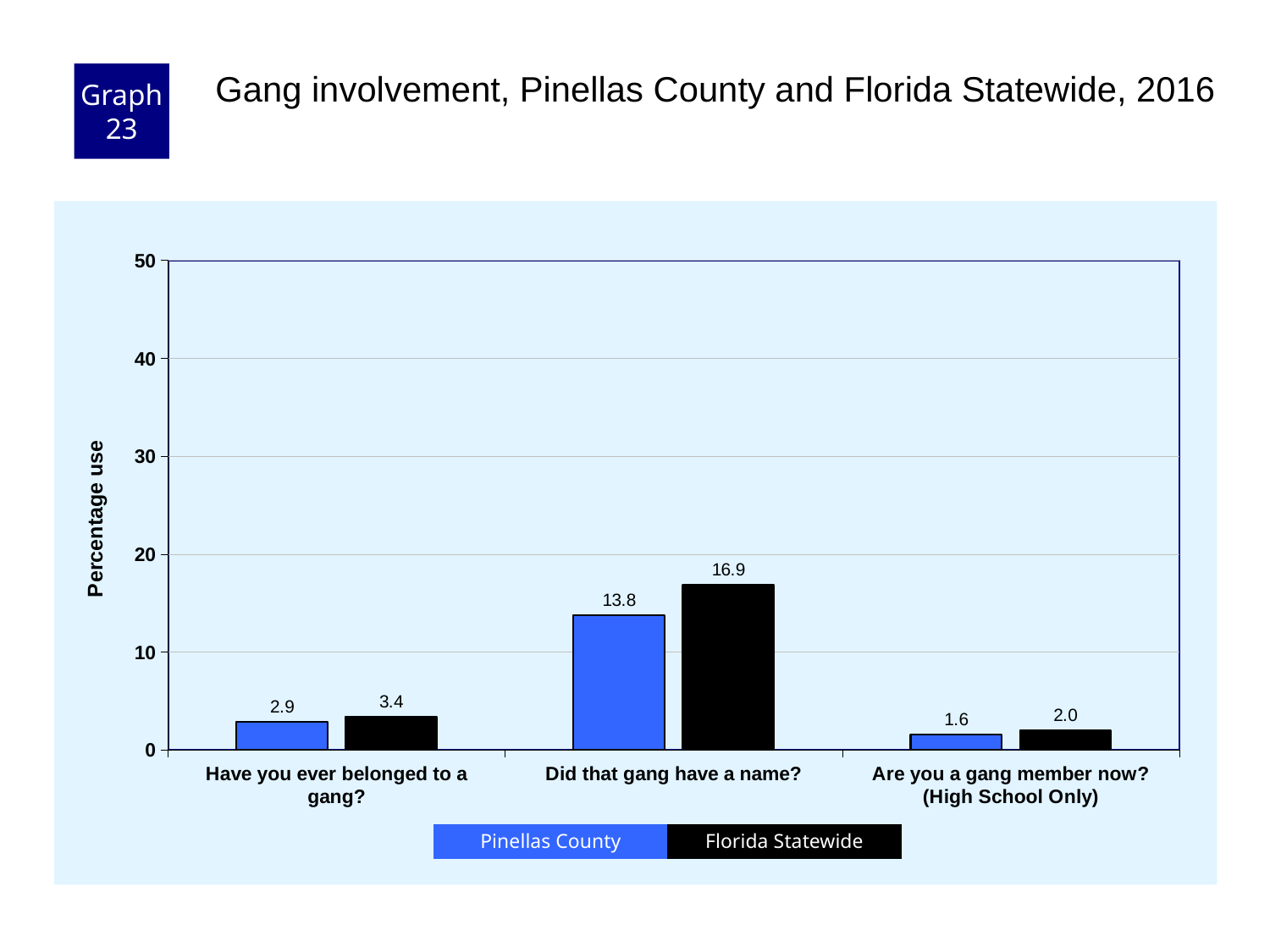
What is the Pinellas County value for "Did that gang have a name?"? 13.8 Which question has the lowest Pinellas County value? Are you a gang member now? (High School Only) What is the label on the y axis? Percentage use For "Have you ever belonged to a gang?", which is larger: Pinellas County or Florida Statewide? Florida Statewide What kind of chart is shown? bar chart Is the Florida Statewide value for "Did that gang have a name?" greater or less than 20? less What is the Florida Statewide value for "Have you ever belonged to a gang?"? 3.4 How many series does the legend list? 2 Which question has the highest Florida Statewide value? Did that gang have a name? What is the Pinellas County value for "Are you a gang member now? (High School Only)"? 1.6 What is the difference between the Florida Statewide and Pinellas County values for "Did that gang have a name?"? 3.1 How many questions (categories) are shown on the x axis? 3